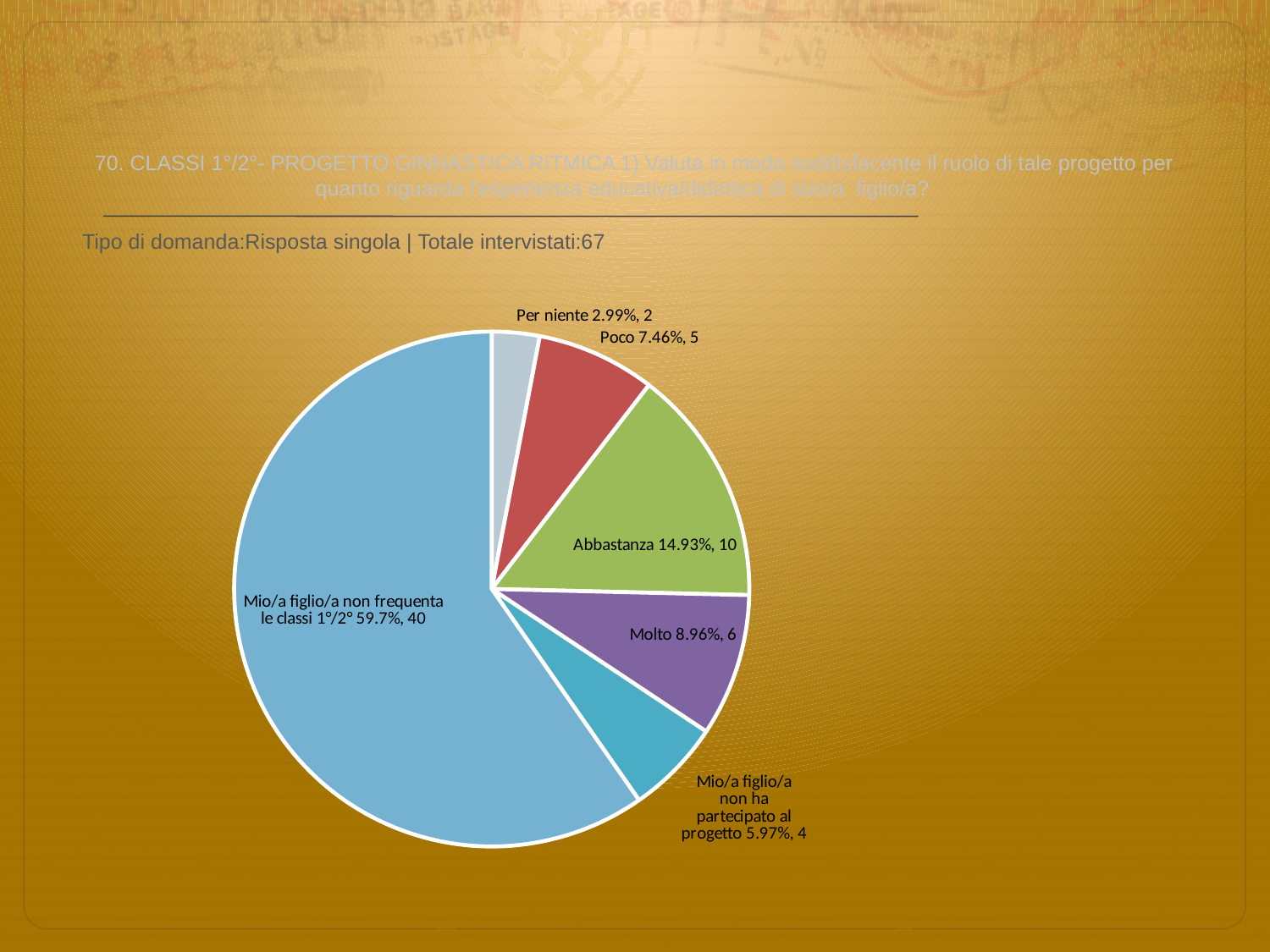
Which category has the smallest slice of the pie? Per niente What kind of chart is shown on the slide? Pie chart How many respondents answered "Poco"? 5 Which category has the largest slice of the pie? Mio/a figlio/a non frequenta le classi 1°/2° How many respondents answered "Molto"? 6 What is the difference in count between "Abbastanza" and "Molto"? 4 What percentage share does the "Per niente" slice represent? 2.99% How many slices does the pie chart have? 6 Which has more respondents, "Poco" or "Mio/a figlio/a non ha partecipato al progetto"? Poco What is the total number of respondents (Totale intervistati) stated on the slide? 67 What percentage share does the "Mio/a figlio/a non ha partecipato al progetto" slice represent? 5.97% What percentage share does the "Abbastanza" slice represent? 14.93%